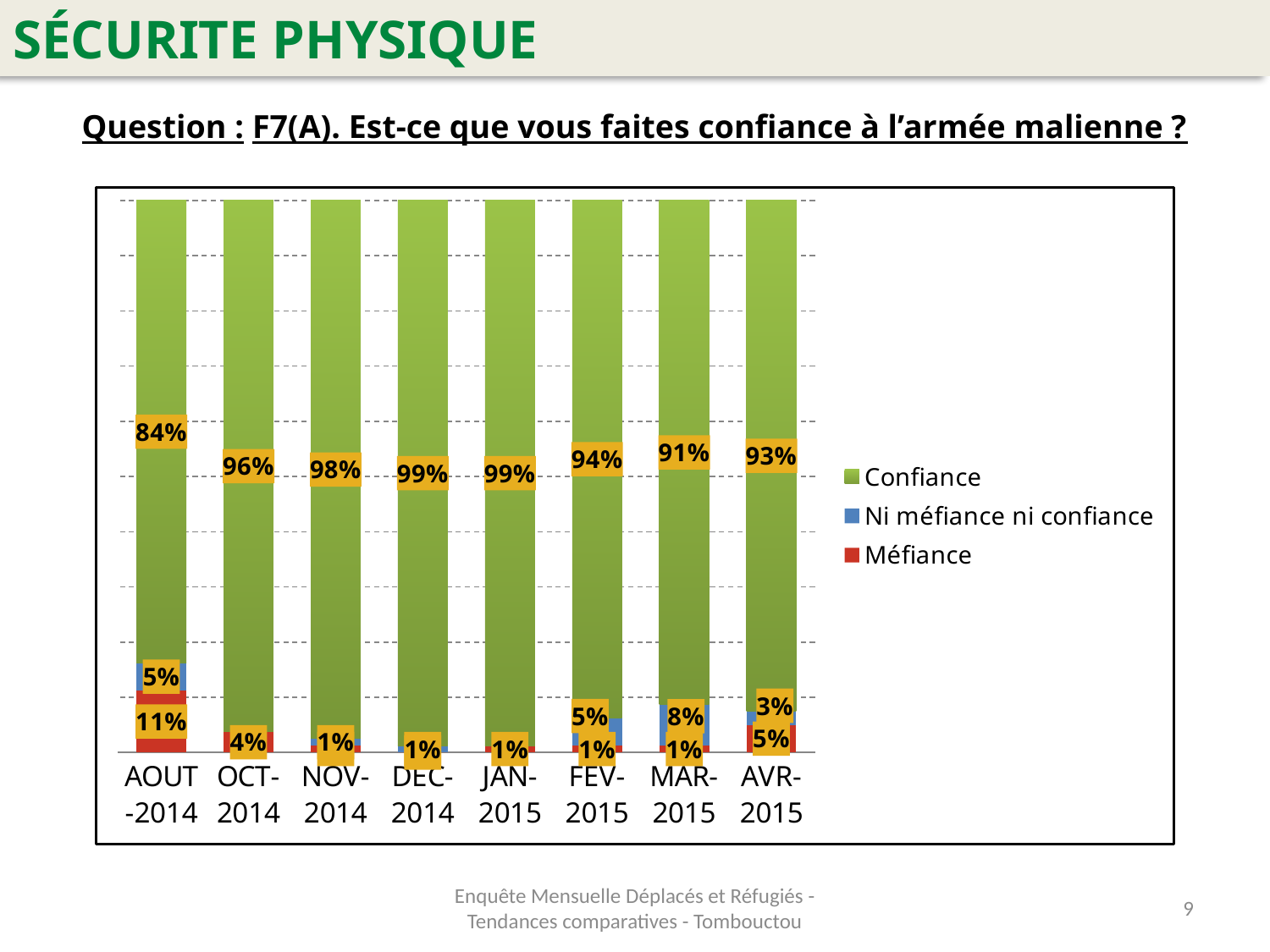
Which colour represents Confiance in the legend? Green What is the difference between the Confiance values for OCT-2014 and AOUT-2014? 12 percentage points Which month has the higher Confiance value, FEV-2015 or MAR-2015? FEV-2015 What is the Méfiance value for AVR-2015? 5% What is the Méfiance value for AOUT-2014? 11% How many months are shown on the x axis? 8 Which month has the lowest Confiance value? AOUT-2014 What is the Confiance value for AOUT-2014? 84% What is the Ni méfiance ni confiance value for MAR-2015? 8% What kind of chart is shown on the slide? Stacked bar chart What is the Confiance value for DEC-2014? 99% How many series does the legend list? 3